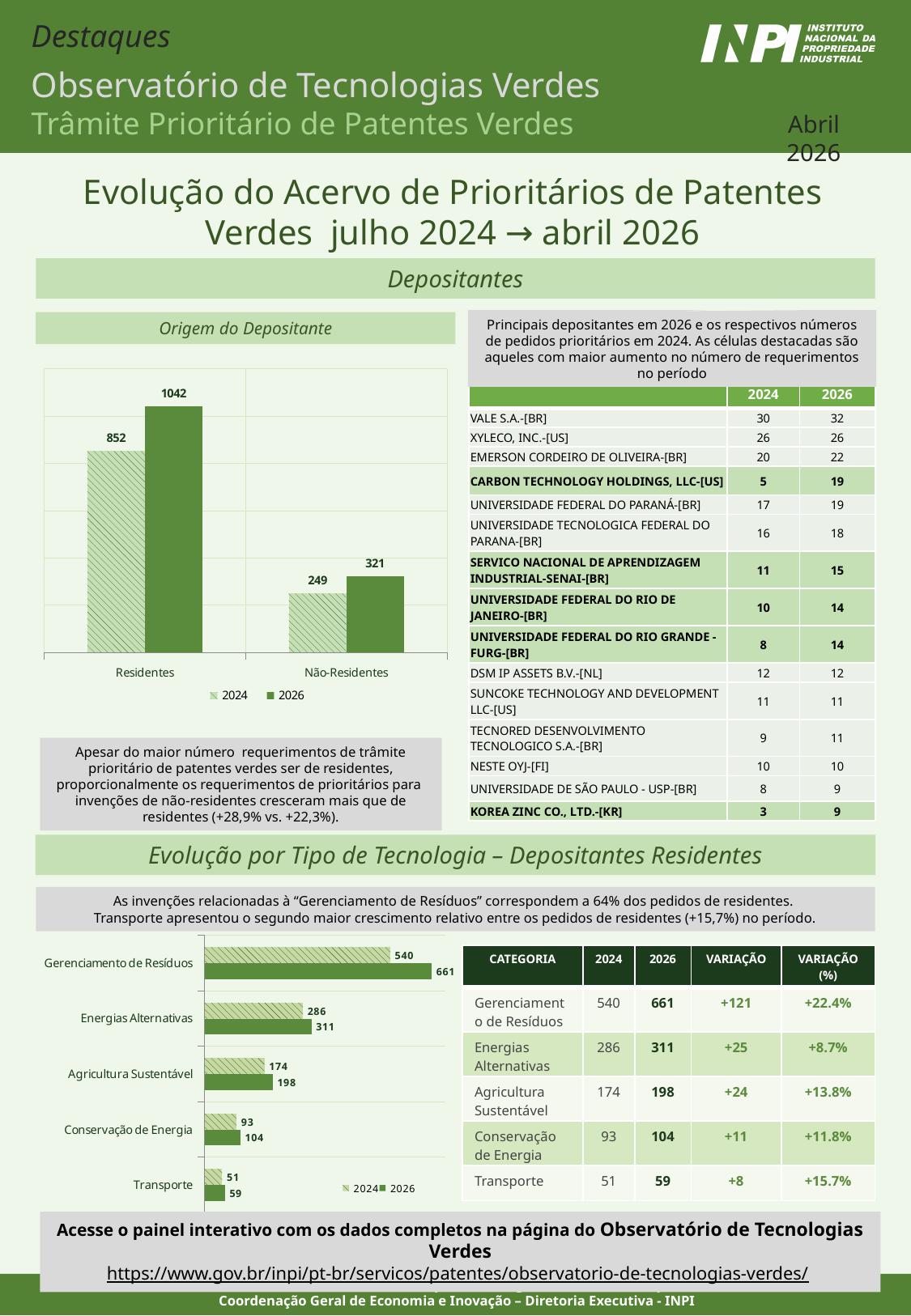
In the 'Evolução por Tipo de Tecnologia' chart, which category has the highest 2024 value? Gerenciamento de Resíduos In the 'Origem do Depositante' chart, how many series does the legend list? 2 In the 'Evolução por Tipo de Tecnologia' chart, which category has the lowest 2026 value? Transporte In the 'Origem do Depositante' chart, what is the difference between the 2026 and 2024 values for Residentes? 190 In the 'Evolução por Tipo de Tecnologia' chart, how many categories are shown? 5 In the 'Evolução por Tipo de Tecnologia' chart, what is the difference between the 2026 and 2024 values for Energias Alternativas? 25 In the 'Origem do Depositante' chart, what is the value for Não-Residentes in 2024? 249 In the 'Evolução por Tipo de Tecnologia' chart, what is the 2024 value for Agricultura Sustentável? 174 In the 'Origem do Depositante' chart, what is the value for Residentes in 2026? 1042 In the 'Evolução por Tipo de Tecnologia' chart, which is larger: the 2026 value for Conservação de Energia or the 2024 value for Agricultura Sustentável? 2024 value for Agricultura Sustentável What kind of chart is the 'Origem do Depositante' chart? Bar chart In the 'Evolução por Tipo de Tecnologia' chart, what is the 2026 value for Gerenciamento de Resíduos? 661